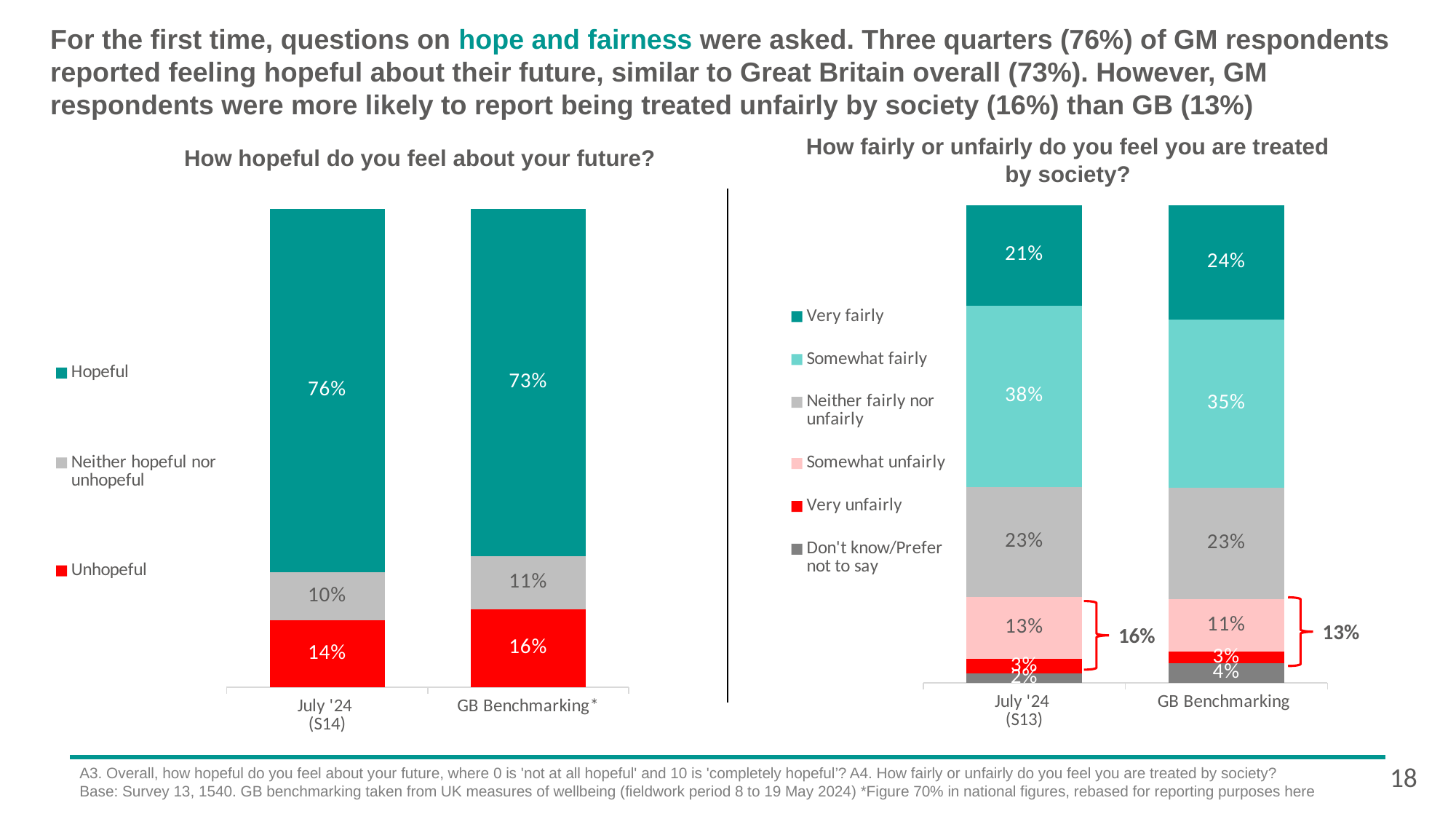
In the 'How hopeful do you feel about your future?' chart, what percentage of July '24 (S14) respondents were Hopeful? 76% In the 'How hopeful do you feel about your future?' chart, what is the Unhopeful value for GB Benchmarking? 16% In the 'How hopeful do you feel about your future?' chart, which bar has the larger 'Neither hopeful nor unhopeful' value, July '24 (S14) or GB Benchmarking? GB Benchmarking How many series does the legend of the 'How fairly or unfairly do you feel you are treated by society?' chart list? 6 In the 'How fairly or unfairly do you feel you are treated by society?' chart, which segment is the smallest in the July '24 (S13) bar? Don't know/Prefer not to say In the 'How fairly or unfairly do you feel you are treated by society?' chart, what is the difference between the Somewhat unfairly values for July '24 (S13) and GB Benchmarking? 2 percentage points In the 'How fairly or unfairly do you feel you are treated by society?' chart, which segment is the largest in the July '24 (S13) bar? Somewhat fairly In the 'How fairly or unfairly do you feel you are treated by society?' chart, what is the Somewhat fairly value for July '24 (S13)? 38% What type of chart is the 'How fairly or unfairly do you feel you are treated by society?' chart? Stacked bar chart In the 'How fairly or unfairly do you feel you are treated by society?' chart, what is the Very fairly value for GB Benchmarking? 24% In the 'How hopeful do you feel about your future?' chart, what is the difference between the Hopeful values for July '24 (S14) and GB Benchmarking? 3 percentage points How many series does the legend of the 'How hopeful do you feel about your future?' chart list? 3